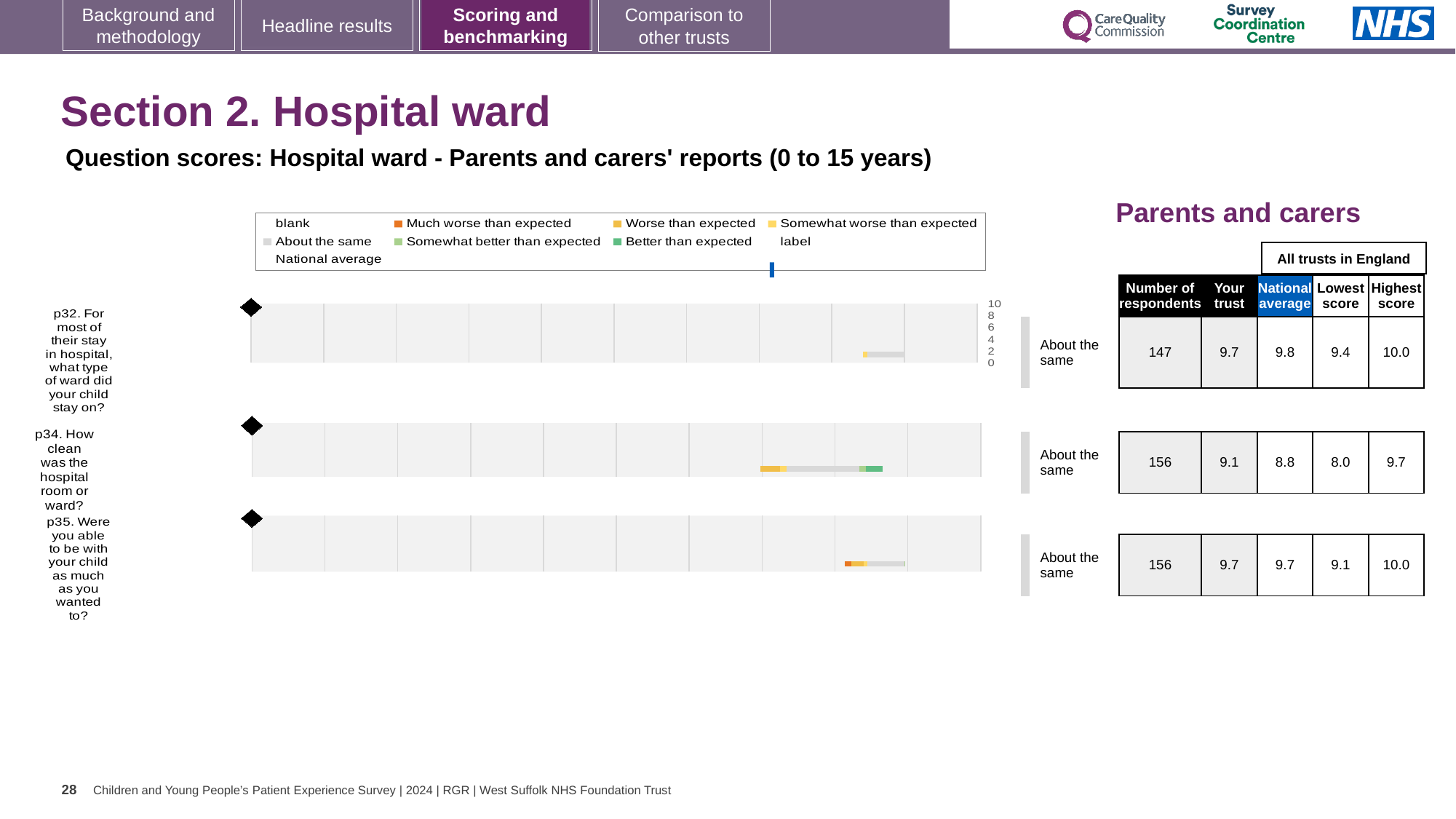
What is the 'Your trust' score for p34 (How clean was the hospital room or ward?)? 9.1 What does the blue marker in the legend represent? National average Which question has the lowest 'Your trust' score? p34. How clean was the hospital room or ward? What benchmark category is shown for p32? About the same What is the difference between the highest score and the lowest score for p34? 1.7 How many respondents answered p35 (Were you able to be with your child as much as you wanted to?)? 156 What is the national average score for p32 (For most of their stay in hospital, what type of ward did your child stay on?)? 9.8 For p34, which is larger: the 'Your trust' score or the national average? Your trust What is the lowest score across all trusts in England for p35? 9.1 What is the difference between the national average and the 'Your trust' score for p32? 0.1 What kind of chart is used to show the question scores on this slide? bar chart How many questions (chart rows) are plotted on the slide? 3